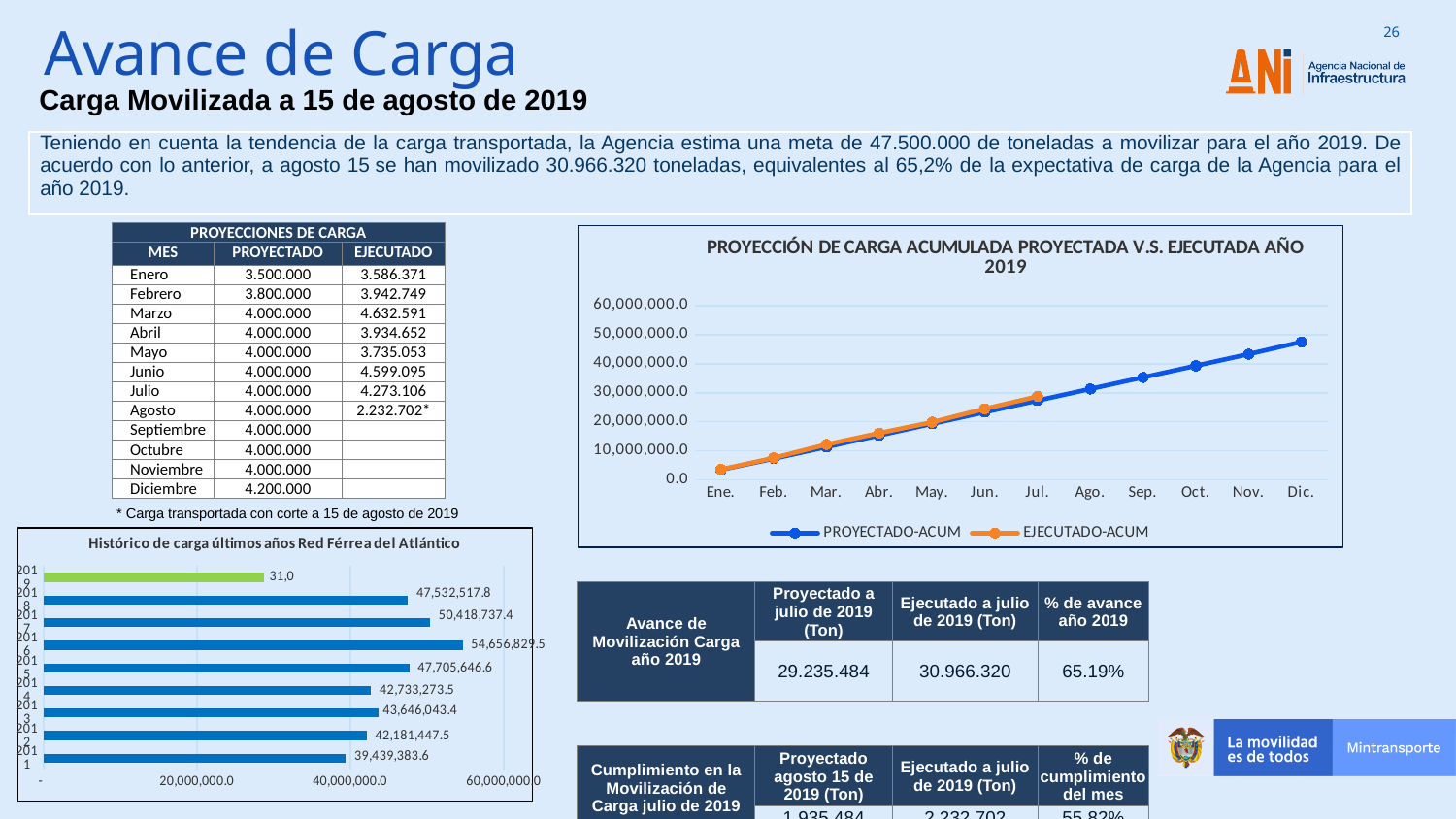
In the 'Histórico de carga últimos años Red Férrea del Atlántico' chart, what is the value for 2016? 54,656,829.5 How many series does the legend of the 'PROYECCIÓN DE CARGA ACUMULADA PROYECTADA V.S. EJECUTADA AÑO 2019' chart list? 2 In the 'PROYECCIÓN DE CARGA ACUMULADA PROYECTADA V.S. EJECUTADA AÑO 2019' chart, is the PROYECTADO-ACUM value for Ene. greater or less than 10,000,000.0? less What type of chart is the 'Histórico de carga últimos años Red Férrea del Atlántico' chart? bar chart What type of chart is the 'PROYECCIÓN DE CARGA ACUMULADA PROYECTADA V.S. EJECUTADA AÑO 2019' chart? line chart In the 'PROYECCIÓN DE CARGA ACUMULADA PROYECTADA V.S. EJECUTADA AÑO 2019' chart, which month is the last one with an EJECUTADO-ACUM data point? Jul. In the 'PROYECCIÓN DE CARGA ACUMULADA PROYECTADA V.S. EJECUTADA AÑO 2019' chart, how many months are shown on the x axis? 12 In the 'Histórico de carga últimos años Red Férrea del Atlántico' chart, which is larger, the value for 2013 or the value for 2014? 2013 In the 'PROYECCIÓN DE CARGA ACUMULADA PROYECTADA V.S. EJECUTADA AÑO 2019' chart, do the PROYECTADO-ACUM values rise or fall from Ene. to Dic.? rise In the 'Histórico de carga últimos años Red Férrea del Atlántico' chart, what is the difference between the values for 2016 and 2018? 7,124,311.7 In the 'PROYECCIÓN DE CARGA ACUMULADA PROYECTADA V.S. EJECUTADA AÑO 2019' chart, is the PROYECTADO-ACUM value for Dic. greater or less than 40,000,000.0? greater In the 'Histórico de carga últimos años Red Férrea del Atlántico' chart, which year has the highest value? 2016